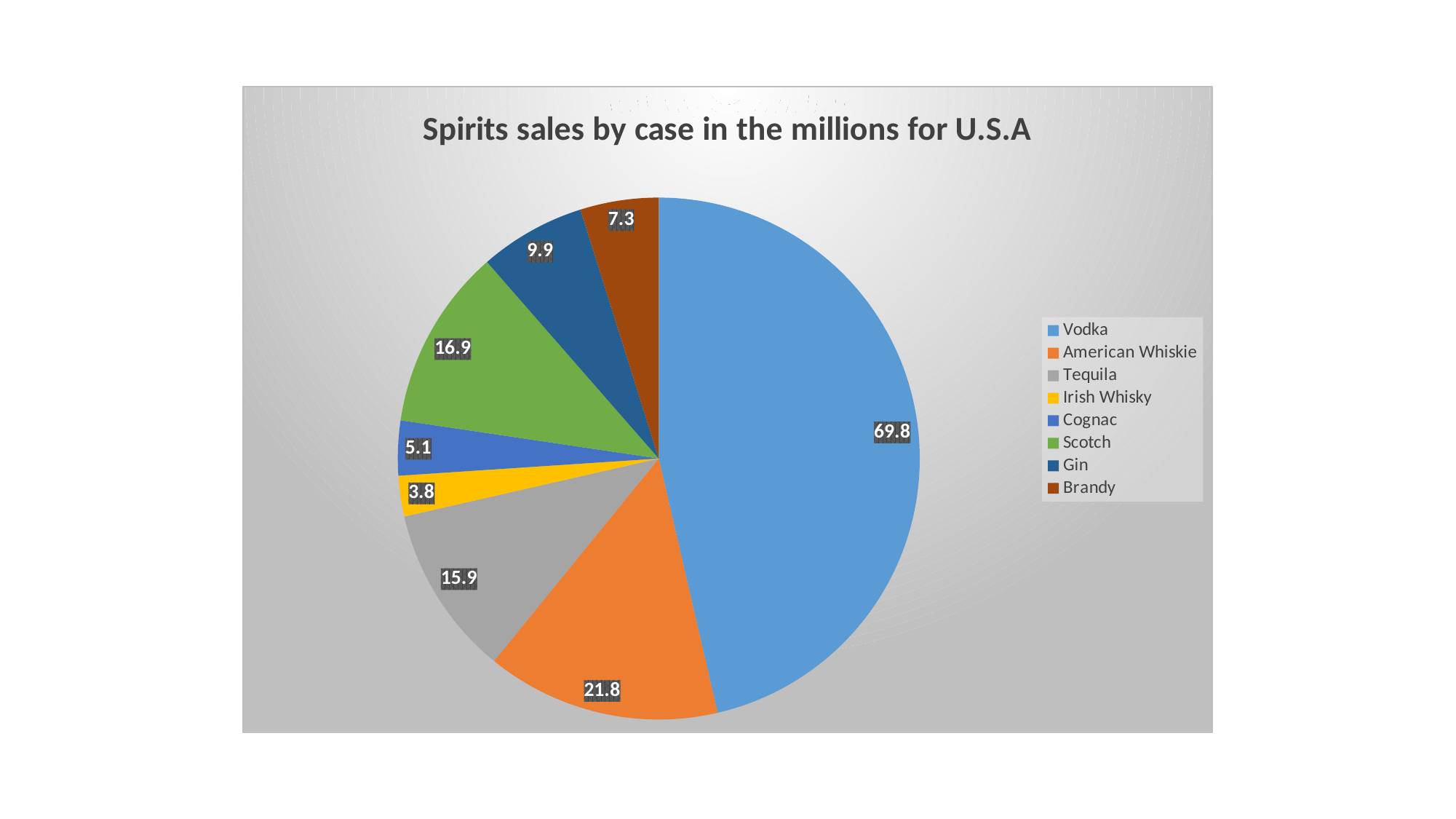
What kind of chart is shown on the slide? Pie chart What is the value for Vodka? 69.8 What is the value for Irish Whisky? 3.8 What is the value for Scotch? 16.9 What is the difference between the values for Scotch and Tequila? 1.0 Which category has the smallest slice? Irish Whisky Which category has the largest slice? Vodka How many categories does the pie chart show? 8 What is the difference between the values for Vodka and American Whiskie? 48.0 Which is larger, the value for Gin or the value for Brandy? Gin What is the value for Gin? 9.9 What is the title of the chart? Spirits sales by case in the millions for U.S.A